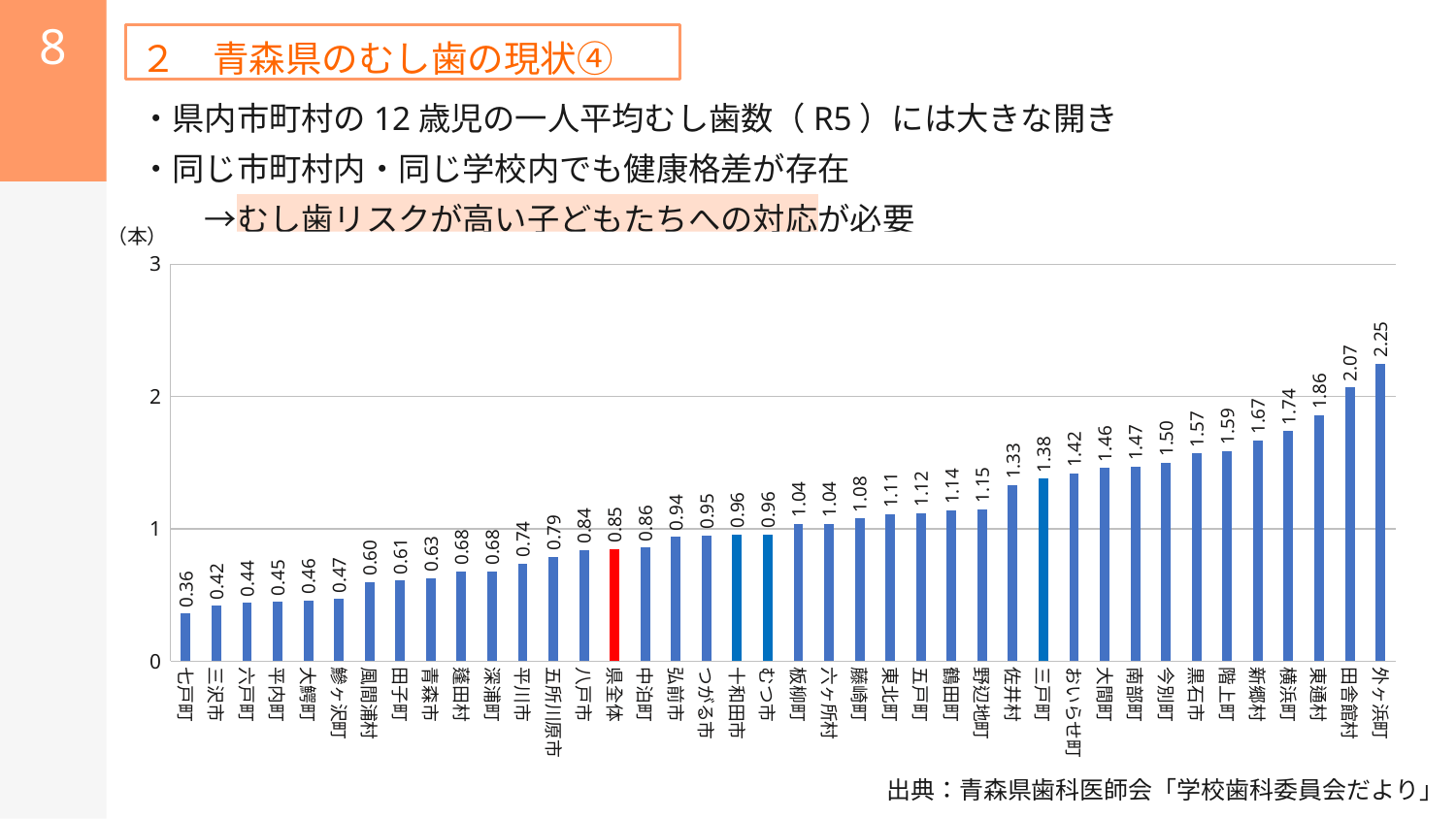
What is the value for 外ヶ浜町? 2.25 How many bars are plotted in the chart? 40 What is the value for 青森市? 0.63 What is the value for 県全体 (the red bar)? 0.85 Which category has the highest value? 外ヶ浜町 Do the values rise or fall from left to right along the x axis? rise Which category has the lowest value? 七戸町 What kind of chart is shown on the slide? bar chart What is the difference between the values for 田舎館村 and 県全体? 1.22 What is the difference between the values for 外ヶ浜町 and 七戸町? 1.89 Is the value for 東通村 greater or less than 2? less Which is larger, the value for 八戸市 or the value for 弘前市? 弘前市